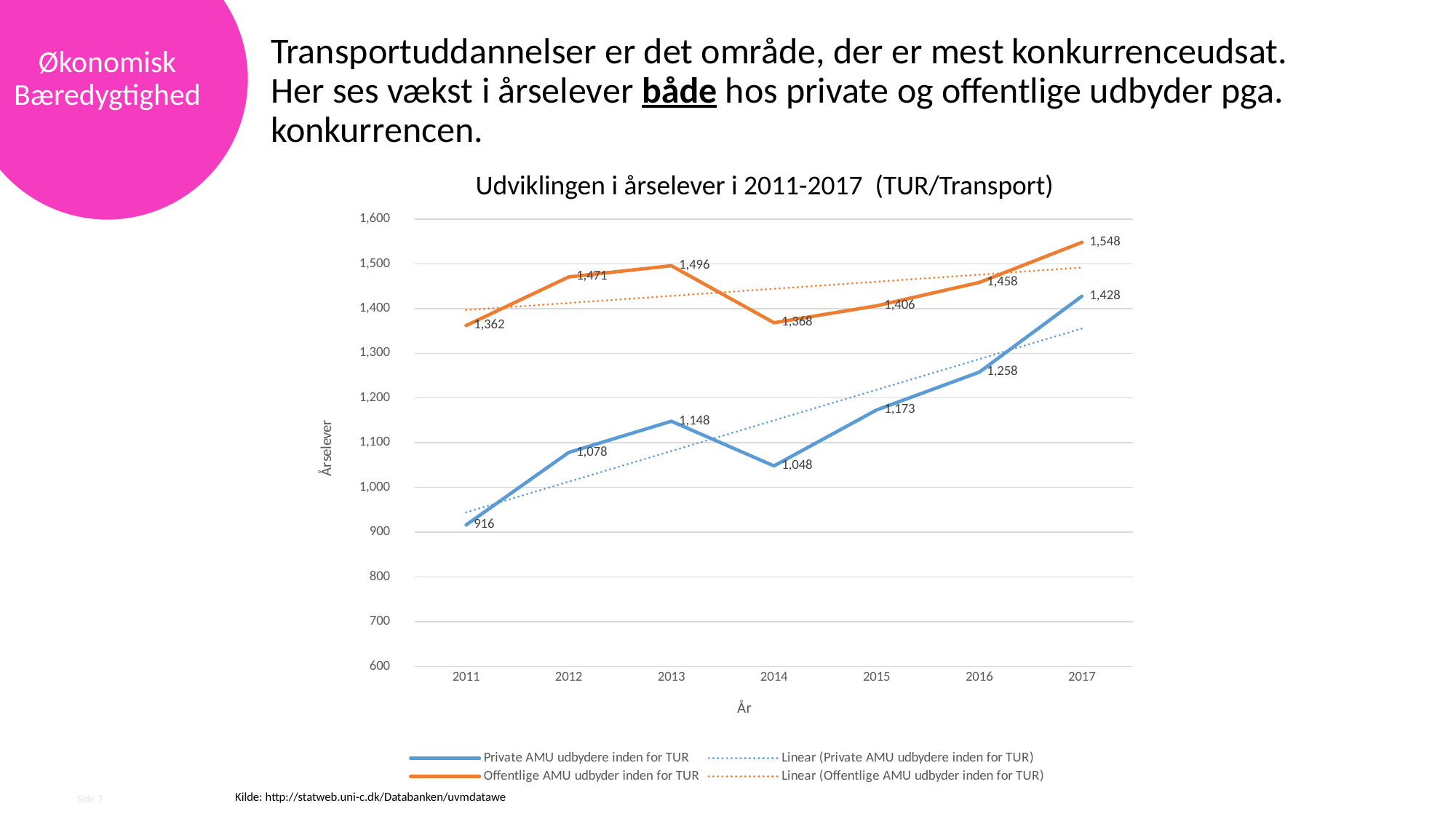
In which year is the value for Offentlige AMU udbyder inden for TUR lowest? 2011 Which is larger: the Offentlige AMU udbyder value in 2013 or in 2016? 2013 What kind of chart is shown on the slide? line chart What is the title of the chart? Udviklingen i årselever i 2011-2017 (TUR/Transport) How many years are shown on the x axis? 7 Is the value for Private AMU udbydere inden for TUR in 2016 greater or less than 1,200? greater What is the difference between the Offentlige AMU udbyder and Private AMU udbydere values in 2017? 120 How many entries does the legend list? 4 In which year is the value for Private AMU udbydere inden for TUR highest? 2017 What is the value for Private AMU udbydere inden for TUR in 2014? 1,048 What is the value for Offentlige AMU udbyder inden for TUR in 2017? 1,548 What is the value for Private AMU udbydere inden for TUR in 2011? 916